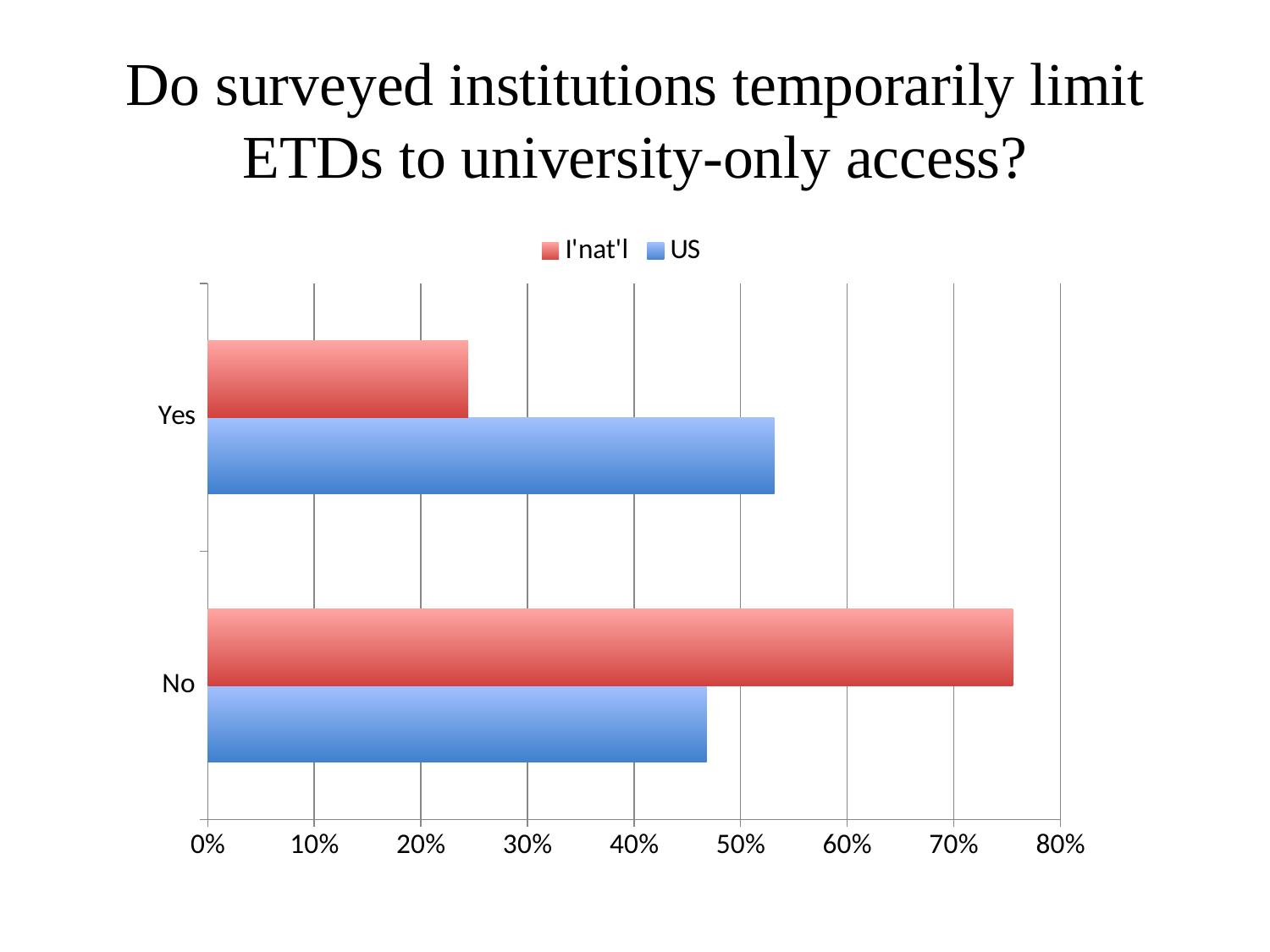
Is the US value for No greater or less than 50%? less Which series is shown in blue? US For the No category, which series has the larger value, I'nat'l or US? I'nat'l Is the US value for Yes greater or less than 50%? greater How many categories are shown on the vertical axis? 2 Which series has the highest value in the chart, and for which category? I'nat'l, No What kind of chart is shown on the slide? bar chart How many series does the legend list? 2 Is the I'nat'l value for No greater or less than 70%? greater Which bar is the shortest in the chart? I'nat'l, Yes For the Yes category, which series has the larger value, I'nat'l or US? US